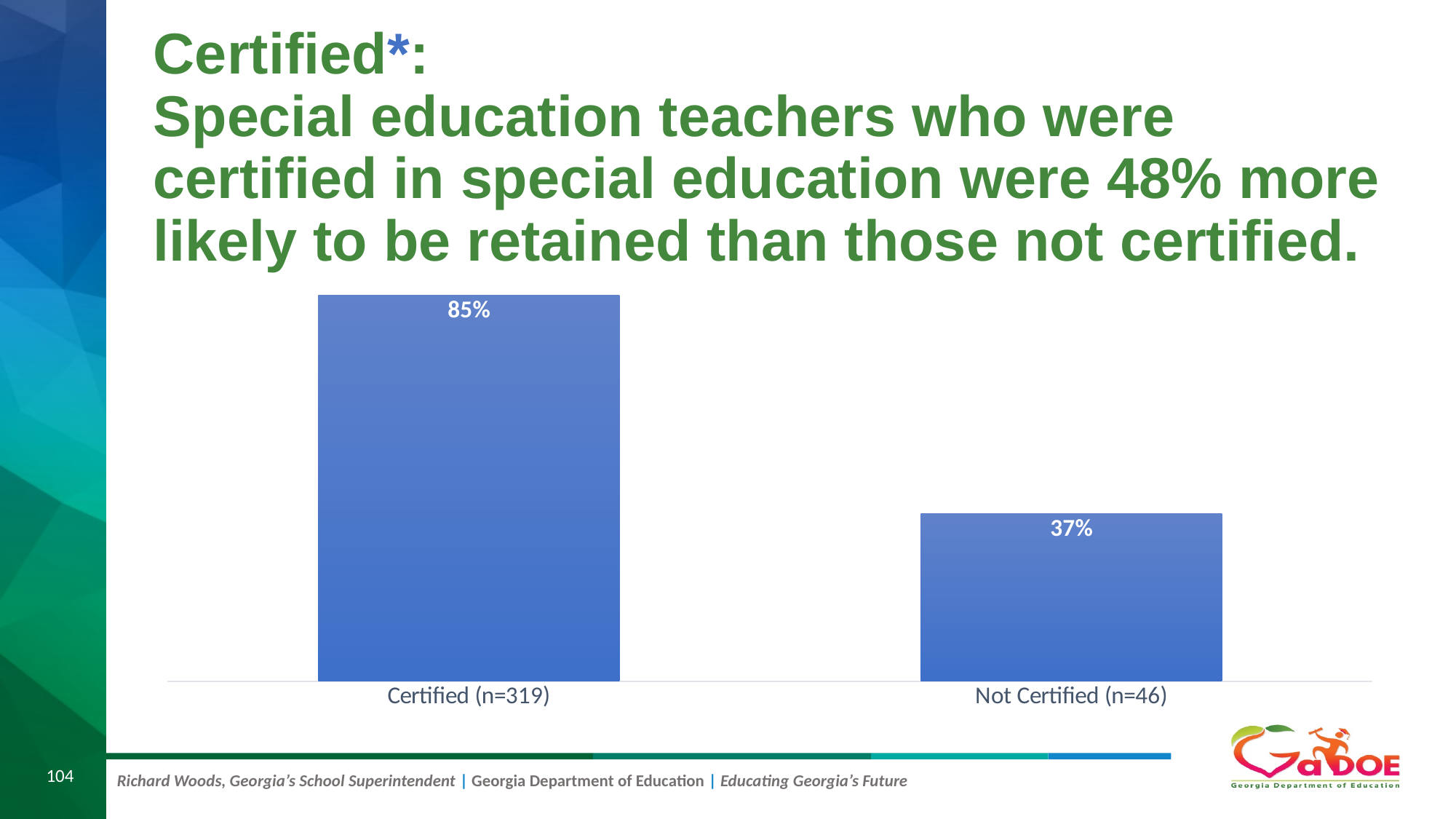
What is the sample size shown in the label for the Not Certified category? n=46 What is the difference between the values for Certified (n=319) and Not Certified (n=46)? 48% What is the value for Not Certified (n=46)? 37% Do the values rise or fall from left to right across the categories? Fall What is the value for Certified (n=319)? 85% Which category has the lowest value? Not Certified (n=46) Which category has the highest value? Certified (n=319) What colour are the bars in the chart? Blue How many categories are shown in the chart? 2 Which is larger, the value for Certified (n=319) or Not Certified (n=46)? Certified (n=319) What kind of chart is shown on the slide? Bar chart